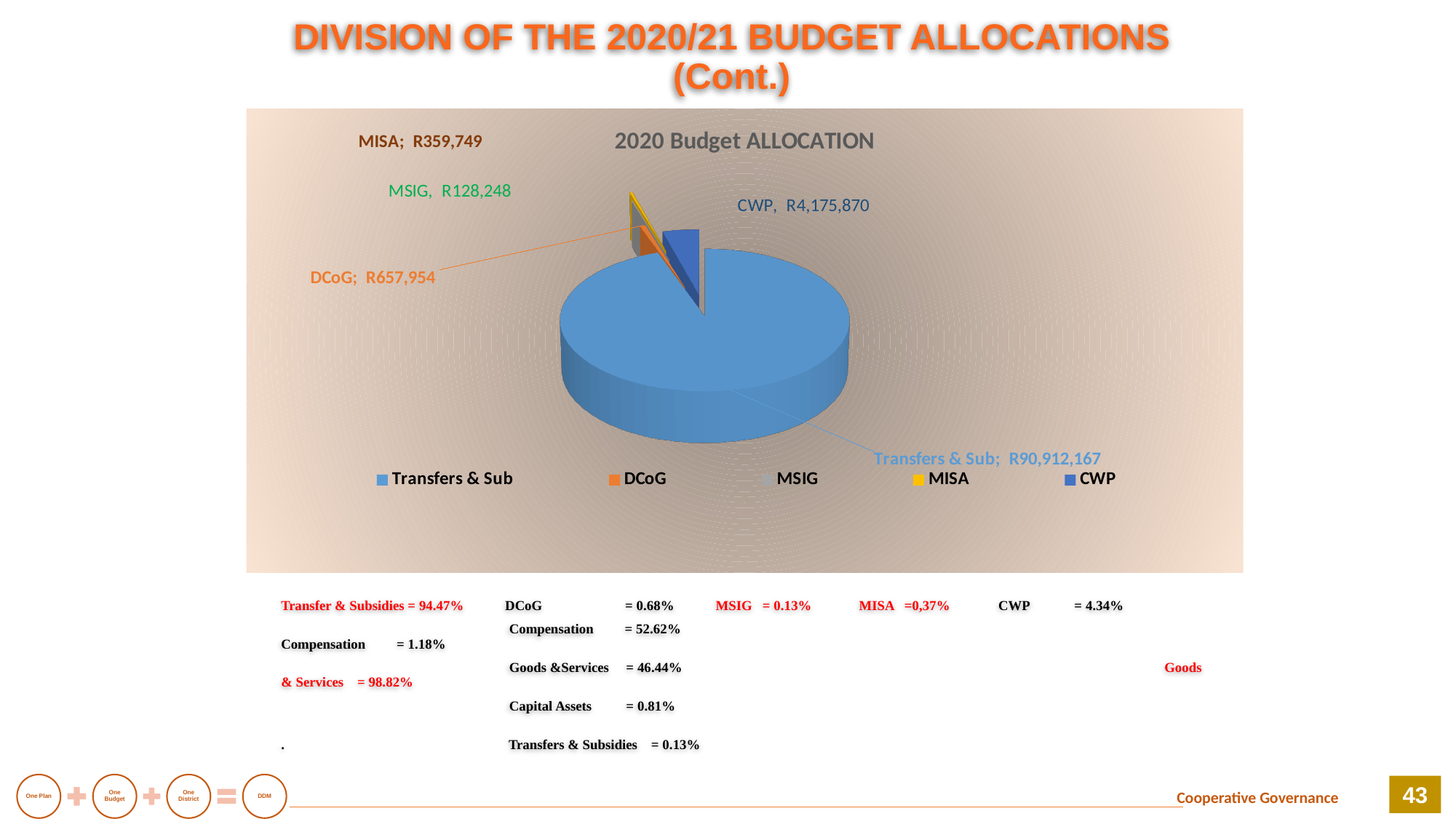
What is the title of the chart? 2020 Budget ALLOCATION What is the value for DCoG? R657,954 Which category has the largest slice of the pie? Transfers & Sub Which is larger, the value for CWP or the value for DCoG? CWP What is the difference between the values for MISA and MSIG? R231,501 Which category has the smallest value? MSIG What is the value for MISA? R359,749 How many entries does the chart legend list? 5 What is the value for Transfers & Sub? R90,912,167 What is the value for CWP? R4,175,870 What kind of chart is shown on the slide? pie chart How many slices does the pie chart have? 5